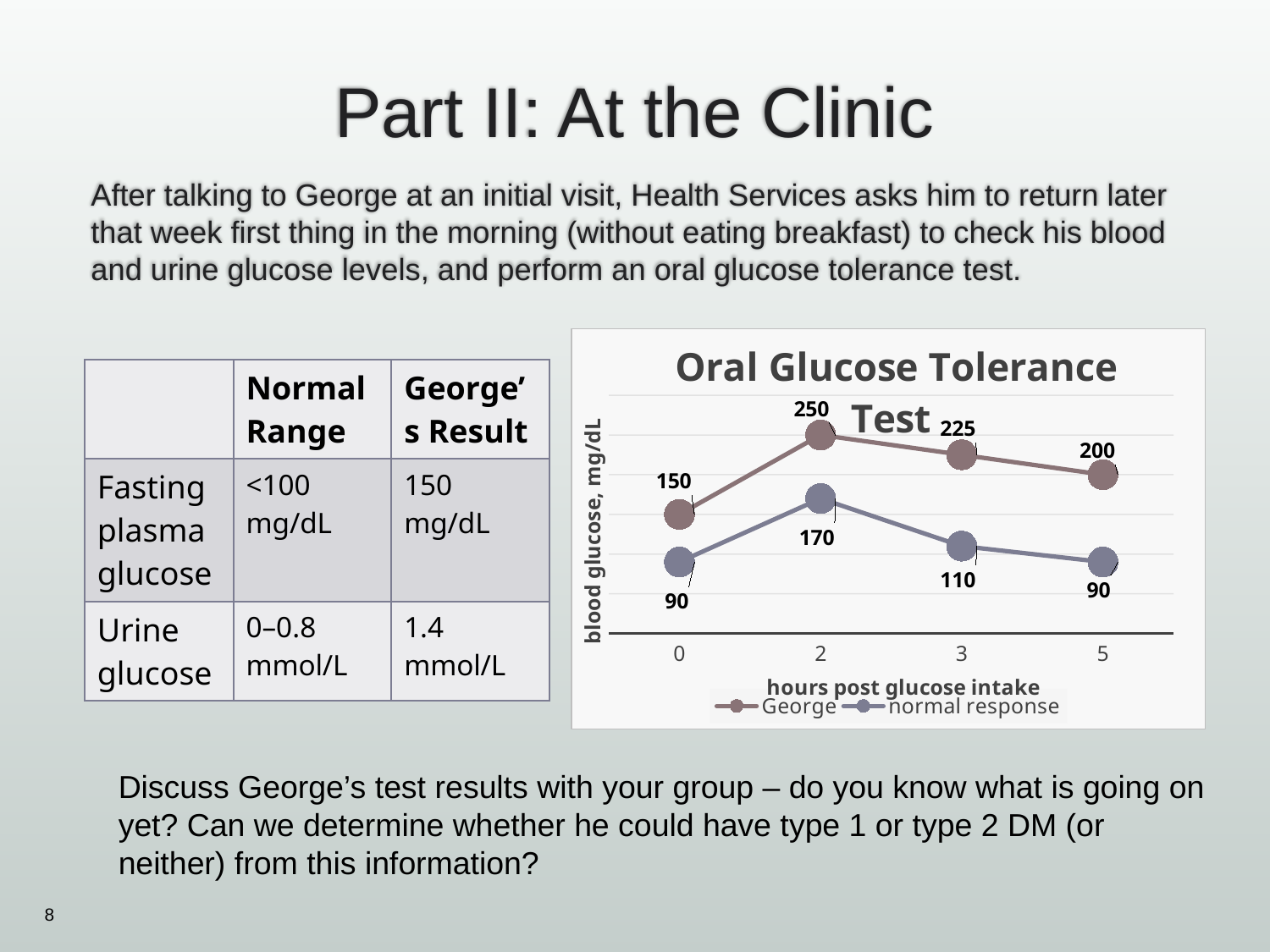
How many series does the legend of the Oral Glucose Tolerance Test chart list? 2 What kind of chart is the Oral Glucose Tolerance Test chart? line chart What is the difference between George's and the normal response blood glucose at 5 hours post glucose intake? 110 What is George's blood glucose at 2 hours post glucose intake? 250 What is George's blood glucose at 0 hours post glucose intake? 150 At how many hours post glucose intake does George's blood glucose reach its highest value? 2 What is the normal response blood glucose at 3 hours post glucose intake? 110 What is the lowest value plotted for the normal response series? 90 How many time points are plotted on the x axis of the Oral Glucose Tolerance Test chart? 4 Does George's blood glucose rise or fall between 2 and 5 hours post glucose intake? fall What is the label of the y axis on the Oral Glucose Tolerance Test chart? blood glucose, mg/dL Which series has the higher blood glucose at 2 hours post glucose intake, George or normal response? George